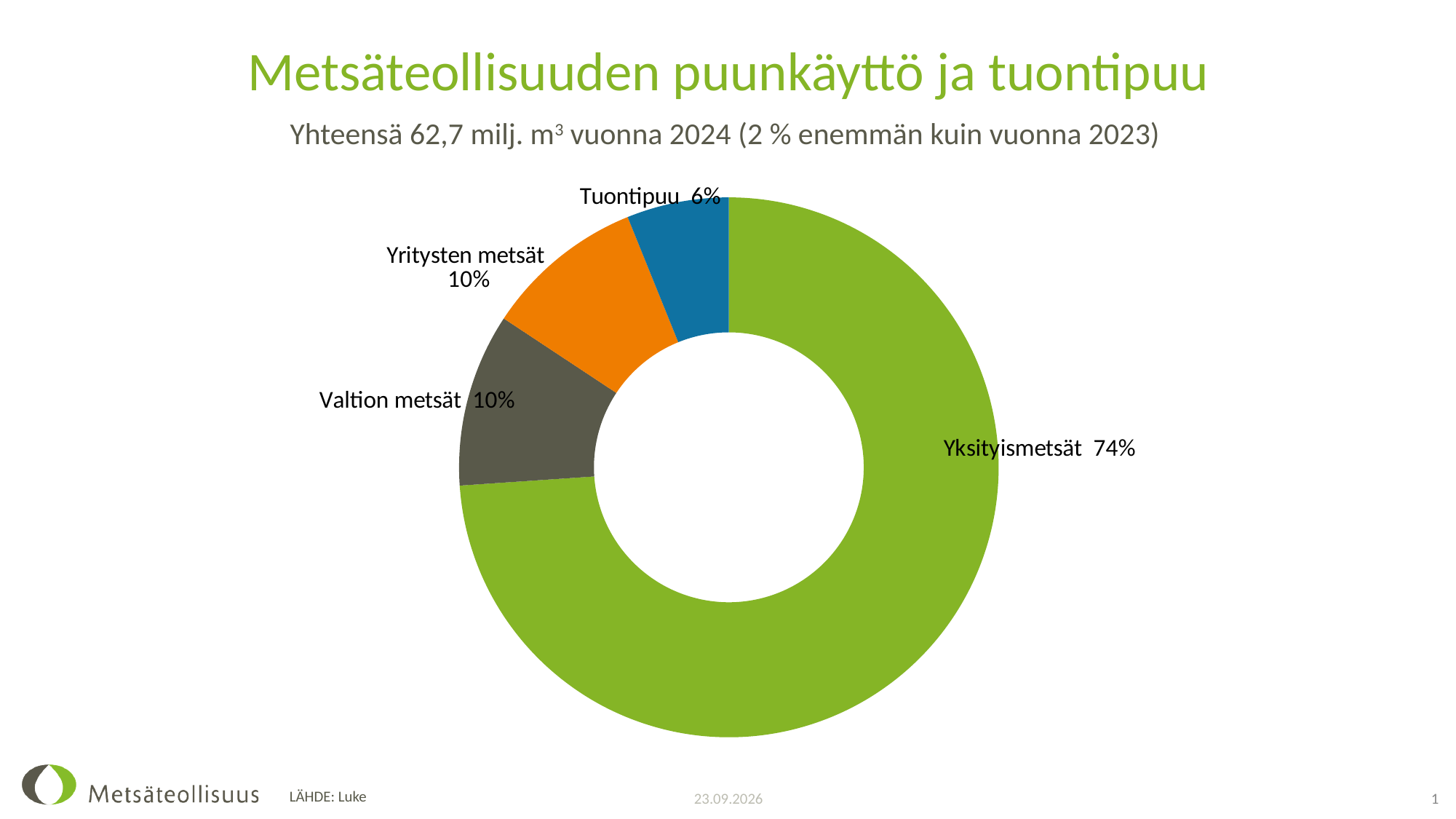
What is the difference in percentage points between Valtion metsät and Tuontipuu? 4 What is the value shown for Valtion metsät? 10% Which is larger, the share for Yritysten metsät or the share for Tuontipuu? Yritysten metsät What is the value shown for Yritysten metsät? 10% Which category has the smallest share of the chart? Tuontipuu Which category has the largest share of the chart? Yksityismetsät What share of the chart does Yksityismetsät account for? 74% What is the value shown for Tuontipuu? 6% What kind of chart is shown on the slide? Pie chart (doughnut) How many categories are shown in the chart? 4 What is the title of the slide? Metsäteollisuuden puunkäyttö ja tuontipuu What is the difference in percentage points between Yksityismetsät and Tuontipuu? 68